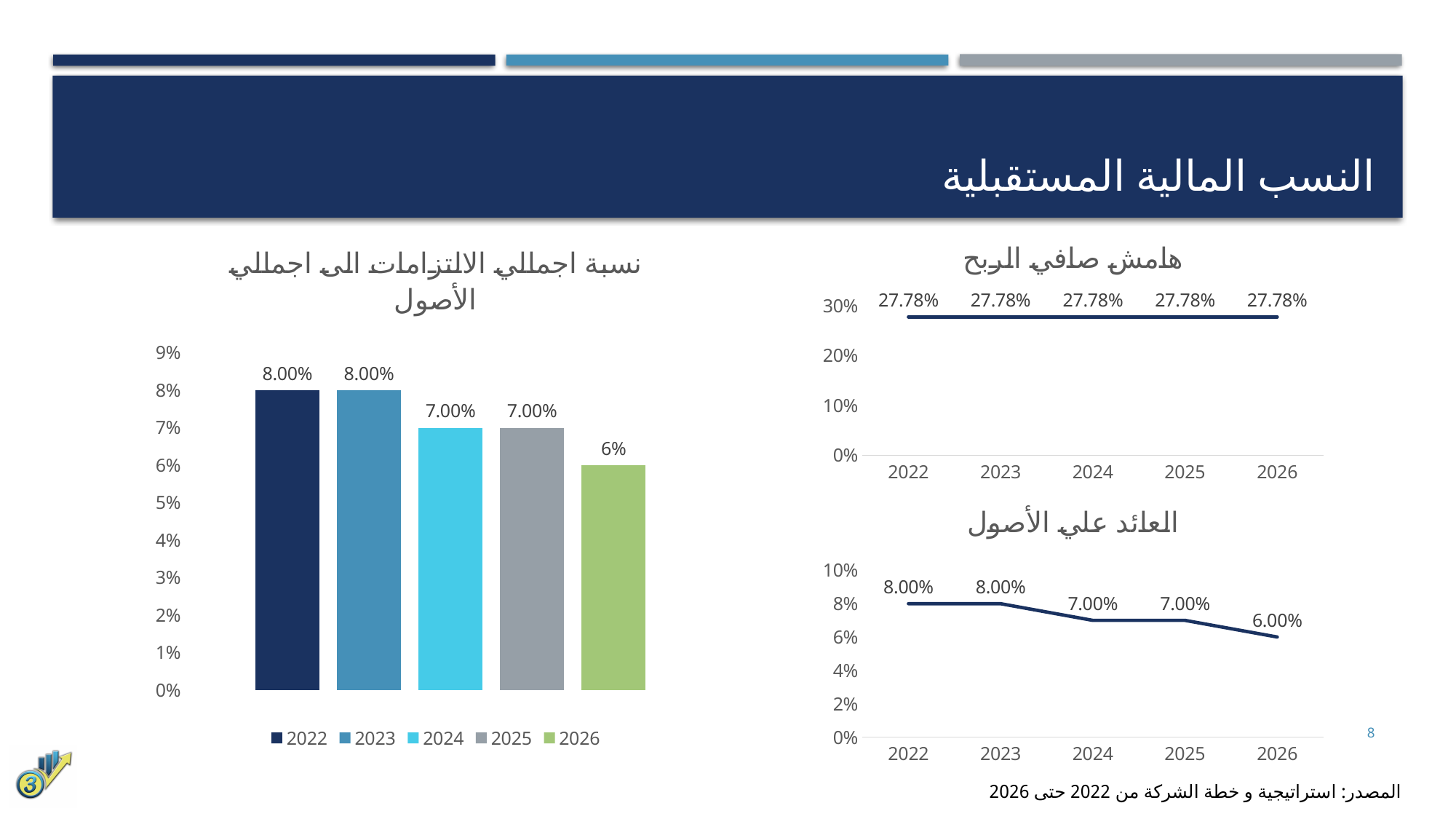
In the bar chart on the left (نسبة اجمالي الالتزامات الى اجمالي الأصول), what is the value for 2024? 7.00% In the bar chart on the left (نسبة اجمالي الالتزامات الى اجمالي الأصول), how many entries does the legend list? 5 In the top-right chart (هامش صافي الربح), what is the value for 2025? 27.78% In the bar chart on the left (نسبة اجمالي الالتزامات الى اجمالي الأصول), how many years are shown? 5 In the bottom-right chart (العائد على الأصول), what is the value for 2026? 6.00% In the bar chart on the left (نسبة اجمالي الالتزامات الى اجمالي الأصول), which year has the lowest value? 2026 In the bar chart on the left (نسبة اجمالي الالتزامات الى اجمالي الأصول), what is the value for 2026? 6% What kind of chart is the top-right chart (هامش صافي الربح)? Line chart What kind of chart is the chart on the left (نسبة اجمالي الالتزامات الى اجمالي الأصول)? Bar chart In the top-right chart (هامش صافي الربح), do the values rise, fall, or stay flat from 2022 to 2026? Stay flat In the bar chart on the left (نسبة اجمالي الالتزامات الى اجمالي الأصول), what is the difference between the 2022 value and the 2026 value? 2% In the bottom-right chart (العائد على الأصول), do the values rise or fall from 2022 to 2026? Fall